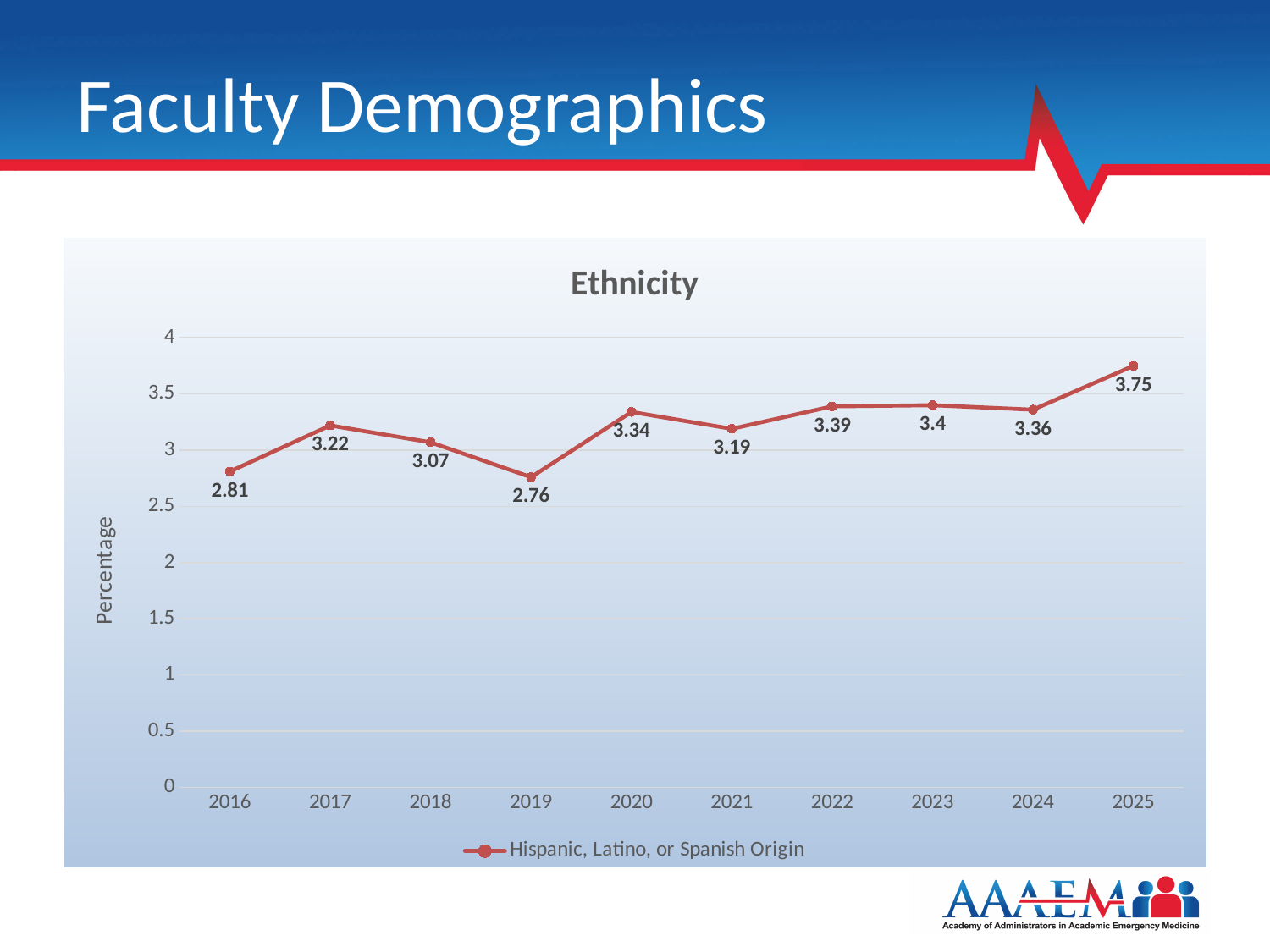
Which is larger, the value for 2017 or the value for 2018? 2017 Which year has the lowest value? 2019 What is the value for 2019? 2.76 What is the title of the chart? Ethnicity What is the value for 2016? 2.81 What is the difference between the values for 2025 and 2016? 0.94 How many years are plotted on the x axis? 10 How many series does the legend list? 1 Is the value for 2024 greater or less than 3? greater What kind of chart is shown? line chart Which year has the highest value? 2025 What is the value for 2023? 3.4